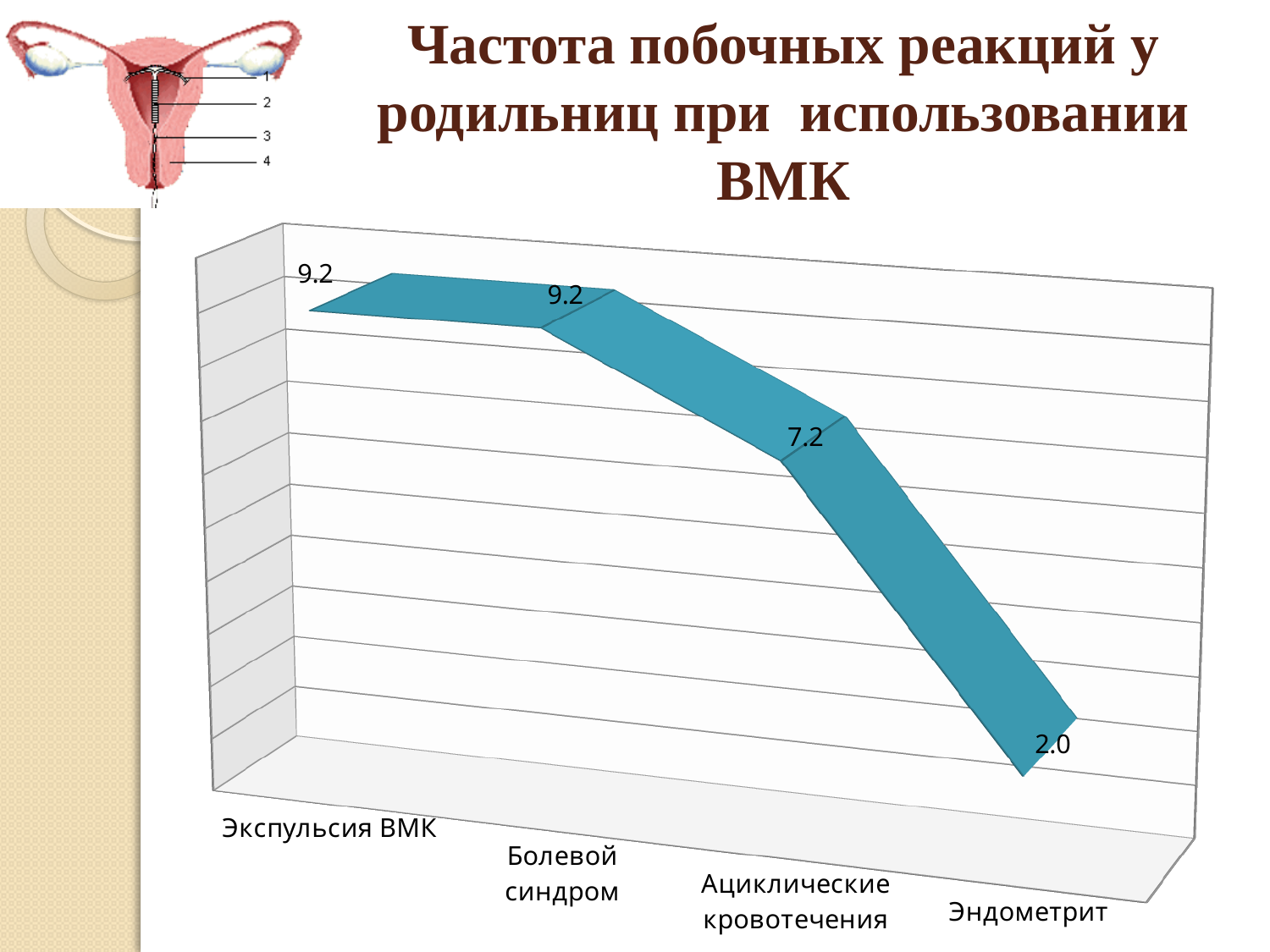
Which is larger, the value for Ациклические кровотечения or the value for Эндометрит? Ациклические кровотечения Do the values rise or fall from left to right along the x axis? Fall Which category has the lowest value? Эндометрит What is the title of the slide? Частота побочных реакций у родильниц при использовании ВМК What is the value for Болевой синдром? 9.2 How many categories are plotted on the chart? 4 What is the value for Эндометрит? 2.0 What is the difference between the values for Ациклические кровотечения and Эндометрит? 5.2 What is the difference between the values for Болевой синдром and Ациклические кровотечения? 2.0 What is the value for Экспульсия ВМК? 9.2 What is the value for Ациклические кровотечения? 7.2 What kind of chart is shown on the slide? Line chart